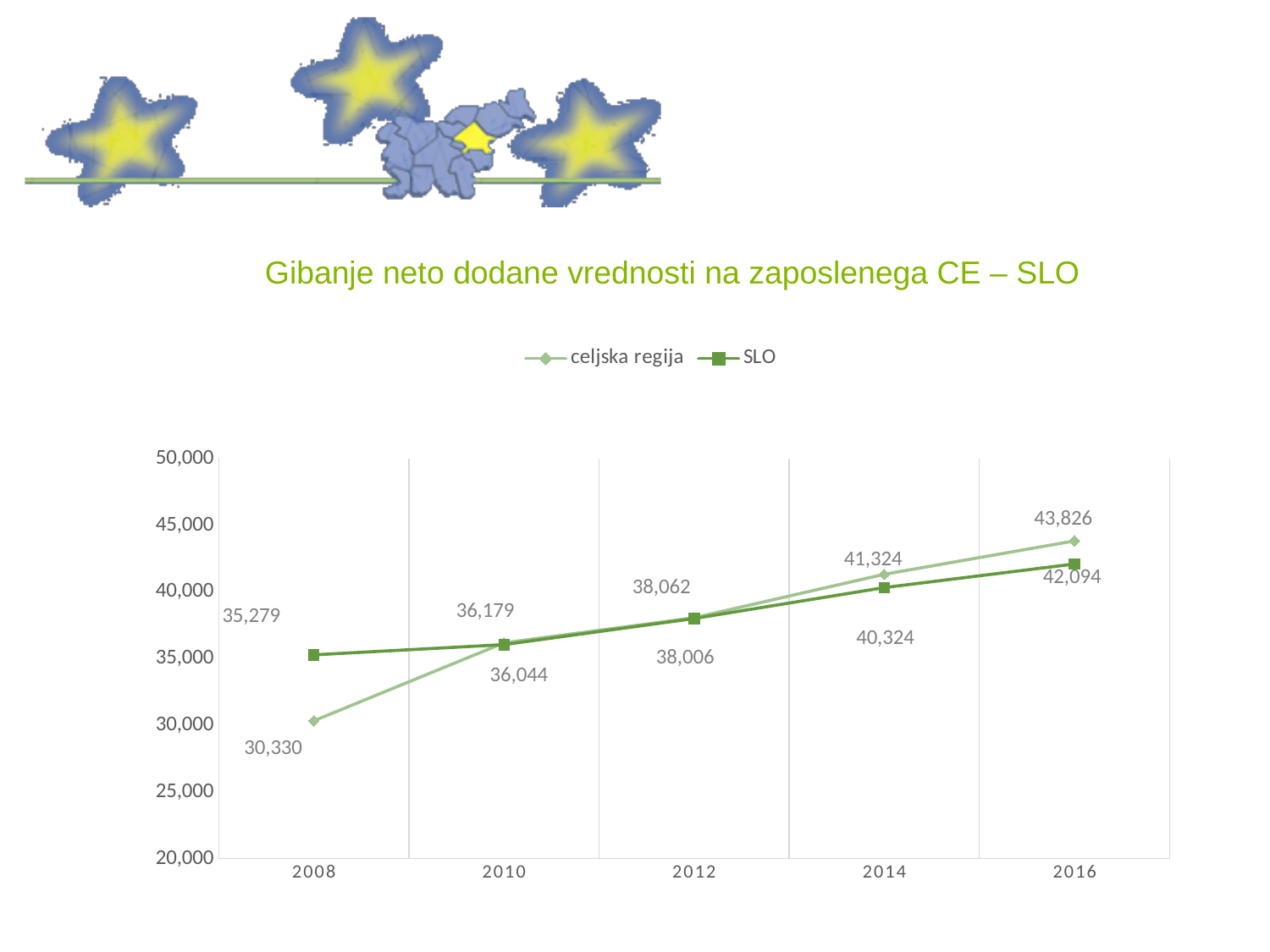
What is the value for celjska regija in 2008? 30,330 How many years are plotted along the x axis? 5 What kind of chart is shown on the slide? line chart Which series has the larger value in 2008, celjska regija or SLO? SLO What is the value for celjska regija in 2016? 43,826 What is the difference between celjska regija and SLO in 2016? 1,732 Do the values for celjska regija rise or fall from 2008 to 2016? rise How many series does the legend list? 2 What is the value for SLO in 2016? 42,094 What is the value for SLO in 2008? 35,279 In which year is the value for celjska regija lowest? 2008 What is the value for SLO in 2014? 40,324